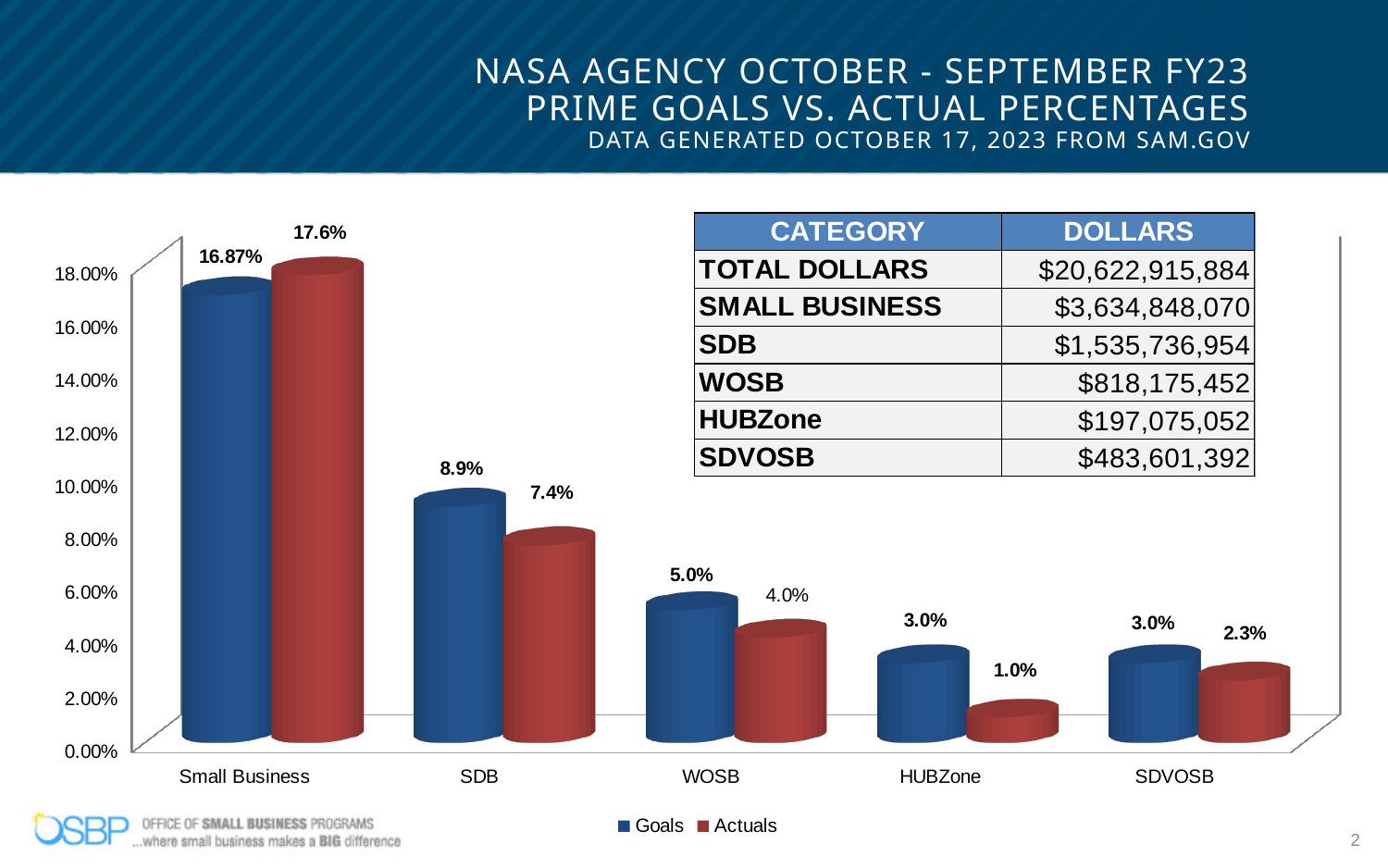
What kind of chart is shown on the slide? bar chart Is the Actuals value for WOSB greater or less than 6.00%? less What is the difference between the Goals and Actuals values for SDVOSB? 0.7% How many categories are shown on the x axis of the chart? 5 Which category has the lowest Actuals value? HUBZone What is the Actuals value for HUBZone? 1.0% What is the Goals value for Small Business? 16.87% Which is larger for Small Business, the Goals value or the Actuals value? Actuals Which category has the highest Actuals value? Small Business What is the Goals value for WOSB? 5.0% How many series does the chart legend list? 2 What is the Actuals value for SDB? 7.4%